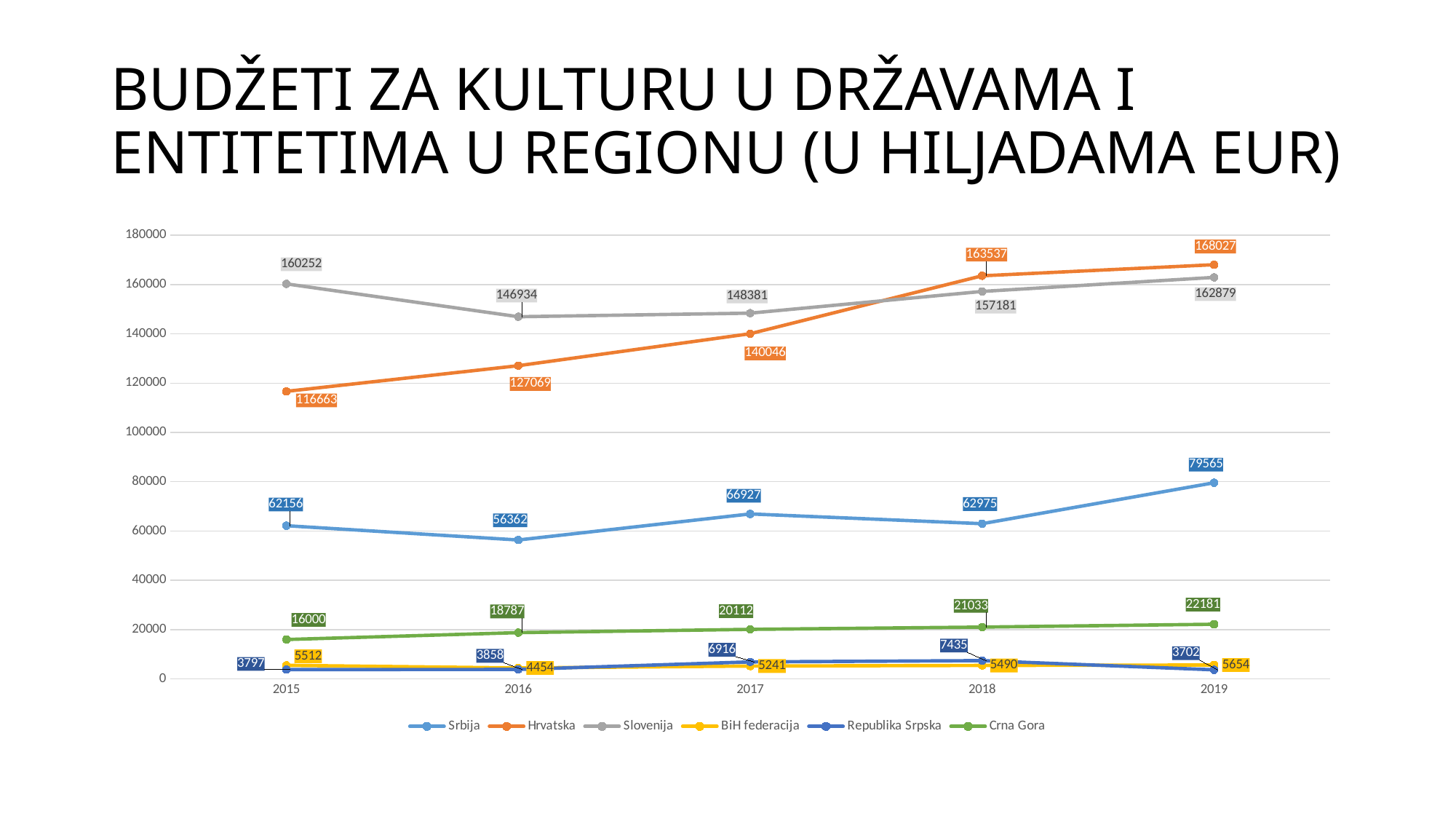
How many series does the legend list? 6 In which year is the value for Hrvatska highest? 2019 In which year is the value for Srbija lowest? 2016 What is the value for Hrvatska in 2017? 140046 What is the difference between the Hrvatska values for 2019 and 2015? 51364 Do the values for Crna Gora rise or fall from 2015 to 2019? rise What is the value for Slovenija in 2016? 146934 How many years are shown on the x axis? 5 What is the value for Srbija in 2019? 79565 What kind of chart is shown on the slide? line chart In 2018, which is larger: the value for Hrvatska or the value for Slovenija? Hrvatska What is the value for Crna Gora in 2018? 21033